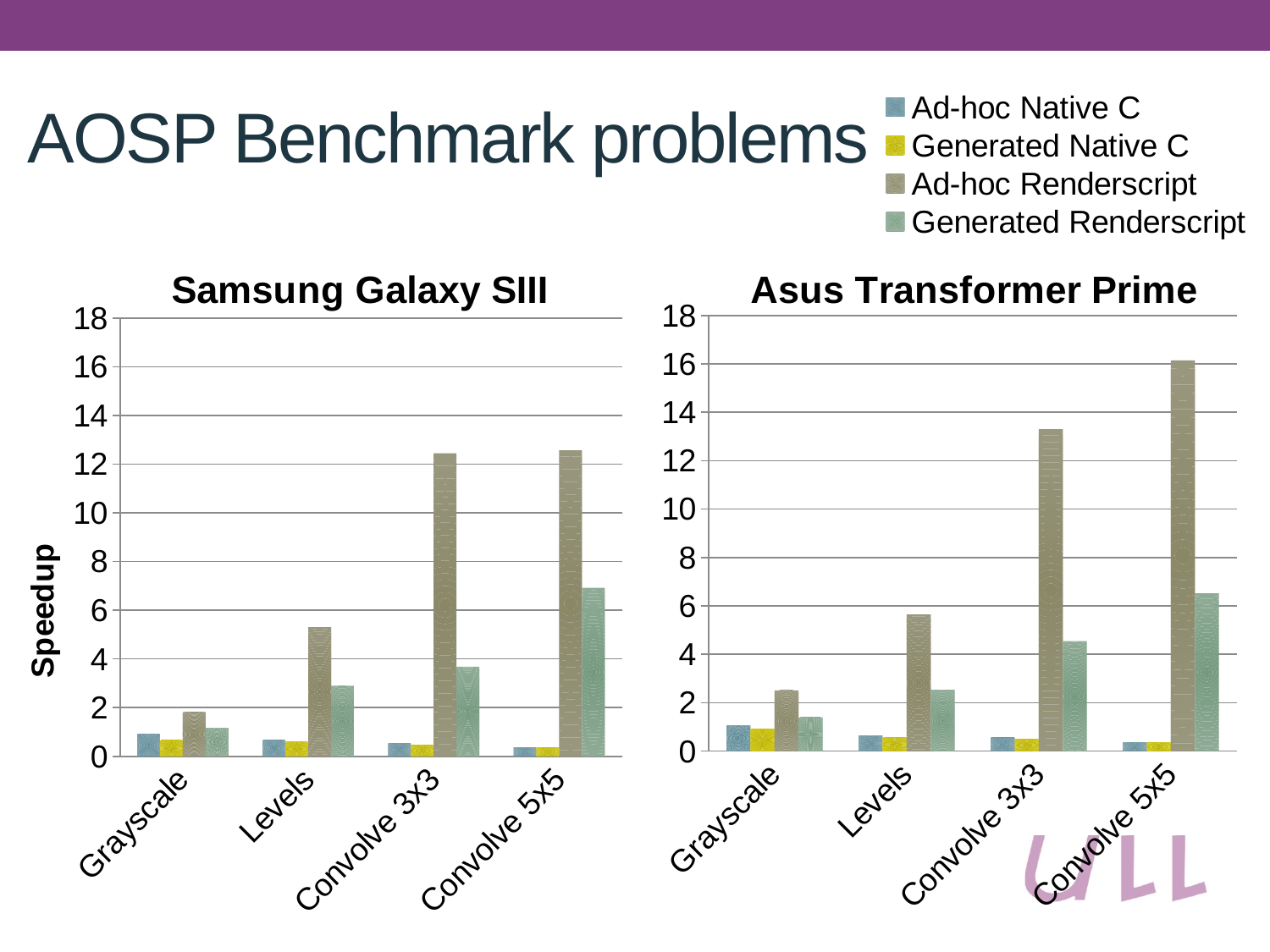
How many benchmark categories are shown on the x axis of the Asus Transformer Prime chart? 4 What is the label on the y axis of the Samsung Galaxy SIII chart? Speedup What kind of chart is the Samsung Galaxy SIII chart? bar chart In the Asus Transformer Prime chart, is the Ad-hoc Renderscript value for Convolve 5x5 greater or less than 14? greater How many series does the legend list? 4 In the Asus Transformer Prime chart, for Convolve 3x3, which is larger: Ad-hoc Renderscript or Generated Renderscript? Ad-hoc Renderscript In the Samsung Galaxy SIII chart, which category has the lowest Ad-hoc Renderscript speedup? Grayscale In the Asus Transformer Prime chart, which category has the highest Ad-hoc Renderscript speedup? Convolve 5x5 In the Samsung Galaxy SIII chart, is the Ad-hoc Renderscript value for Convolve 5x5 greater or less than 10? greater In the Samsung Galaxy SIII chart, is the Generated Renderscript value for Levels greater or less than 4? less In the Samsung Galaxy SIII chart, which category has the highest Generated Renderscript speedup? Convolve 5x5 In the Samsung Galaxy SIII chart, do the Generated Renderscript values rise or fall from Grayscale to Convolve 5x5? rise